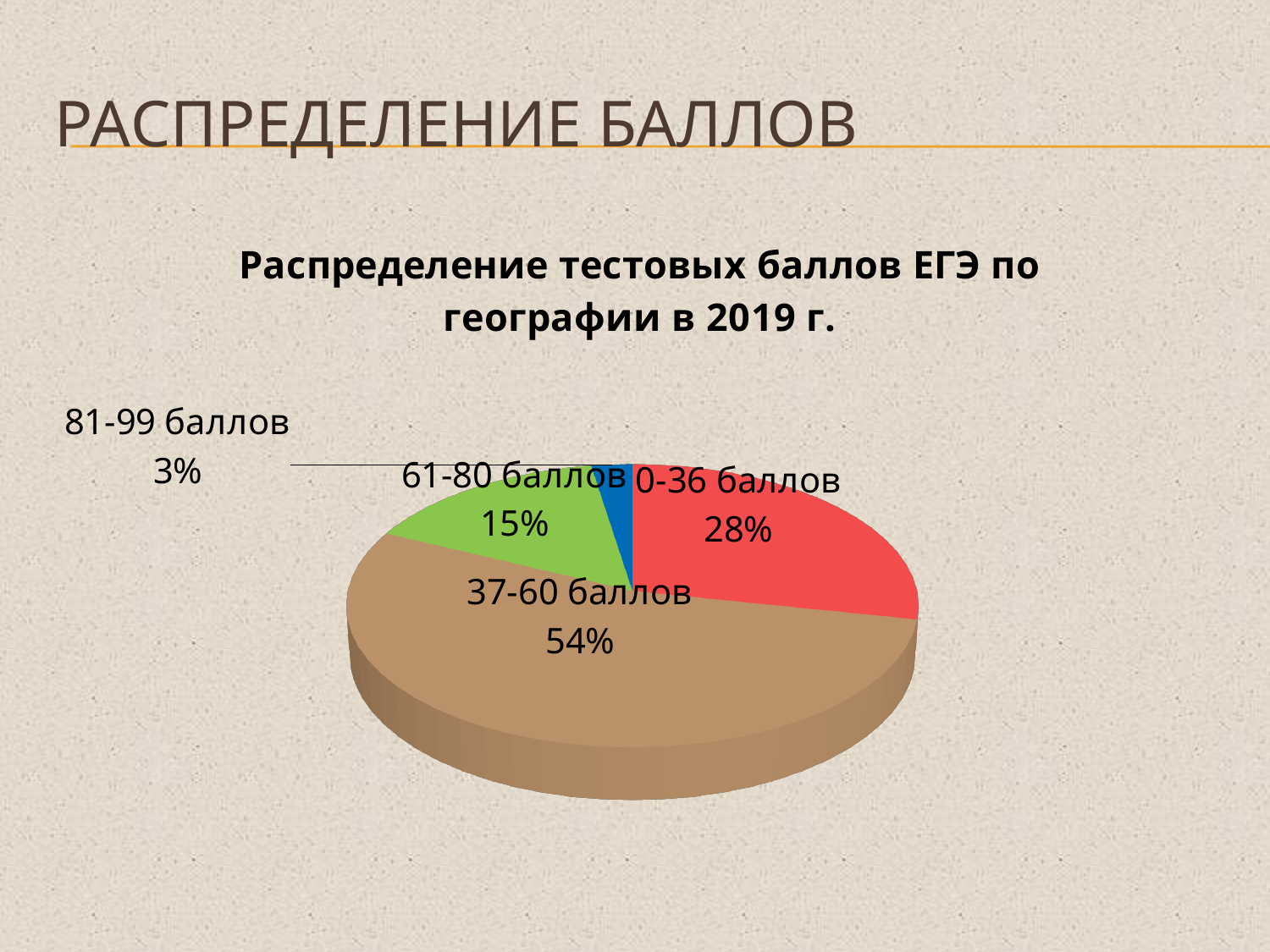
What share of the pie does the 37-60 баллов slice represent? 54% Which score range has the largest share of the pie? 37-60 баллов What is the value shown for 81-99 баллов? 3% What is the difference in percentage points between the 37-60 баллов and 0-36 баллов slices? 26 What is the value shown for 0-36 баллов? 28% Which is larger: the share for 0-36 баллов or for 61-80 баллов? 0-36 баллов What kind of chart is shown on the slide? Pie chart What colour is the 0-36 баллов slice? Red Which score range has the smallest share of the pie? 81-99 баллов How many slices does the pie chart have? 4 What is the value shown for 61-80 баллов? 15% What is the title of the chart? Распределение тестовых баллов ЕГЭ по географии в 2019 г.